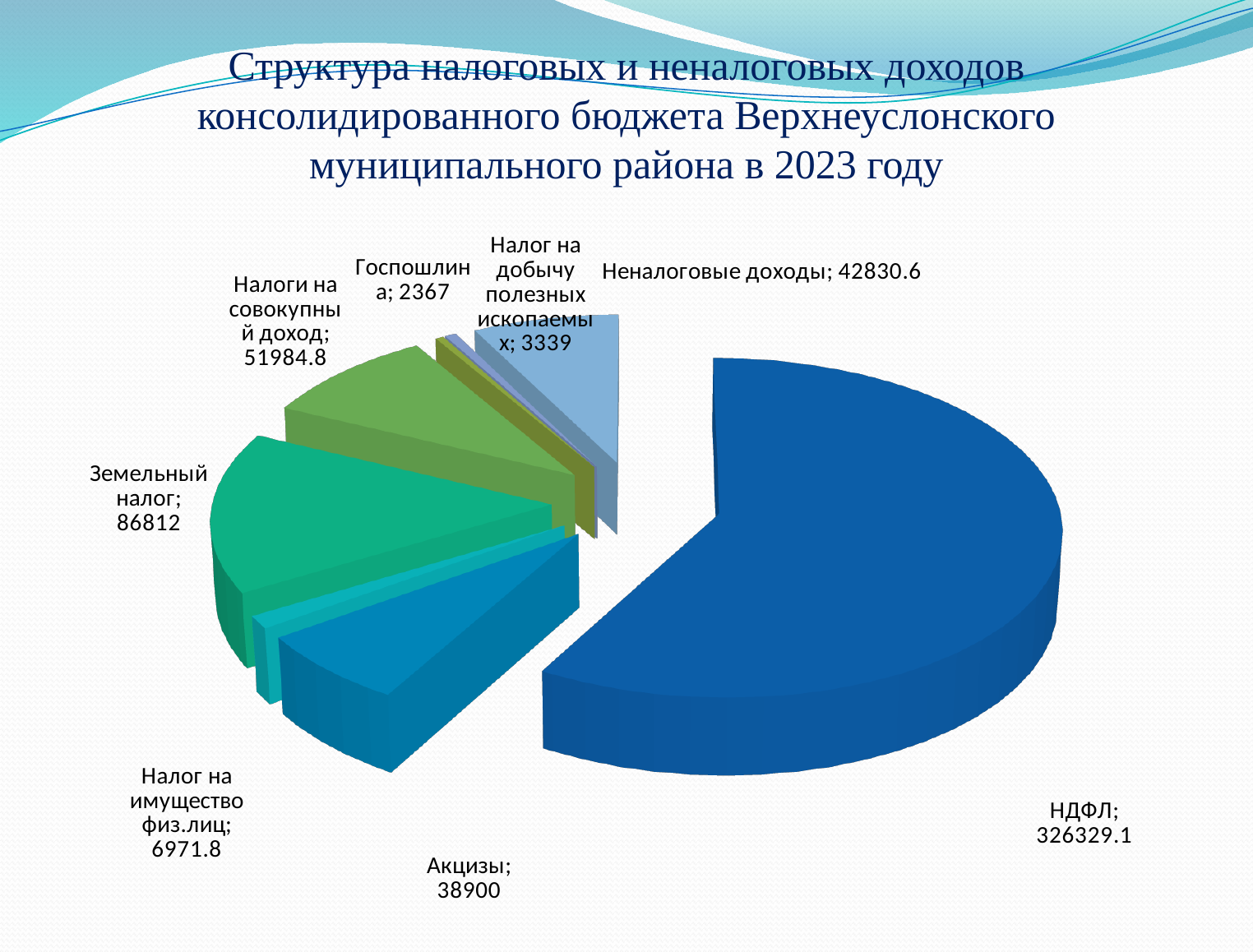
Which is larger, Налоги на совокупный доход or Неналоговые доходы? Налоги на совокупный доход What year does the chart title refer to? 2023 What is the difference between Земельный налог and Акцизы? 47912 Which category has the largest slice of the pie? НДФЛ What value is shown for Госпошлина? 2367 What value is shown for Налог на имущество физ.лиц? 6971.8 What value is shown for Неналоговые доходы? 42830.6 What kind of chart is shown on the slide? Pie chart How many slices does the pie chart have? 8 What value is shown for НДФЛ on the pie chart? 326329.1 Which category has the smallest slice of the pie? Госпошлина What value is shown for Земельный налог? 86812